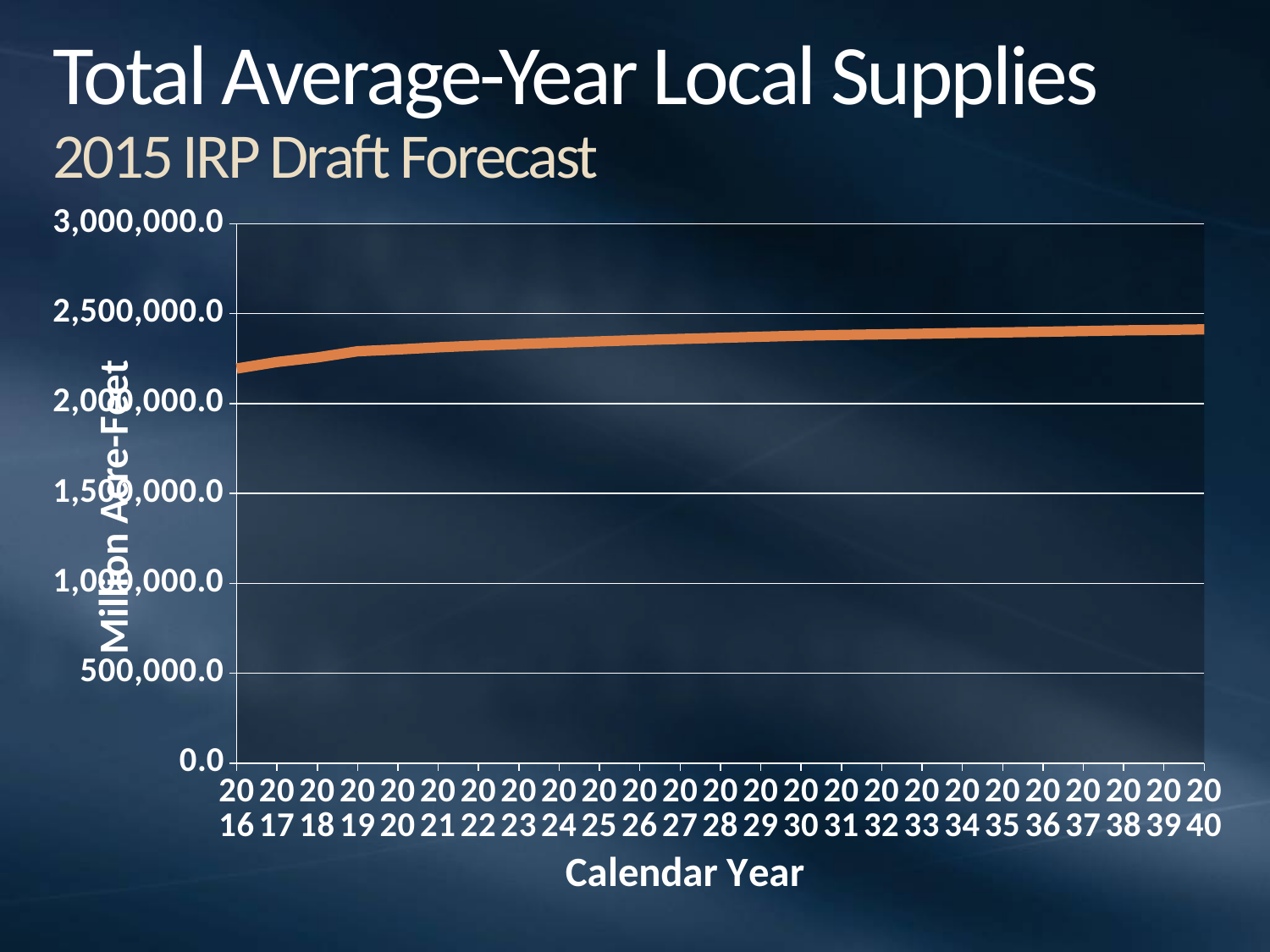
Is the value for 2016 greater or less than 2,000,000.0? greater Which is larger, the value for 2040 or the value for 2016? 2040 Is the value for 2030 greater or less than 1,500,000.0? greater Which calendar year has the highest value? 2040 What kind of chart is shown on the slide? line chart Do the values rise or fall from 2016 to 2040? rise Which calendar year has the lowest value? 2016 Is the value for 2040 greater or less than 2,500,000.0? less What is the label of the y axis? Million Acre-Feet How many calendar years are plotted along the x axis? 25 What is the label of the x axis? Calendar Year